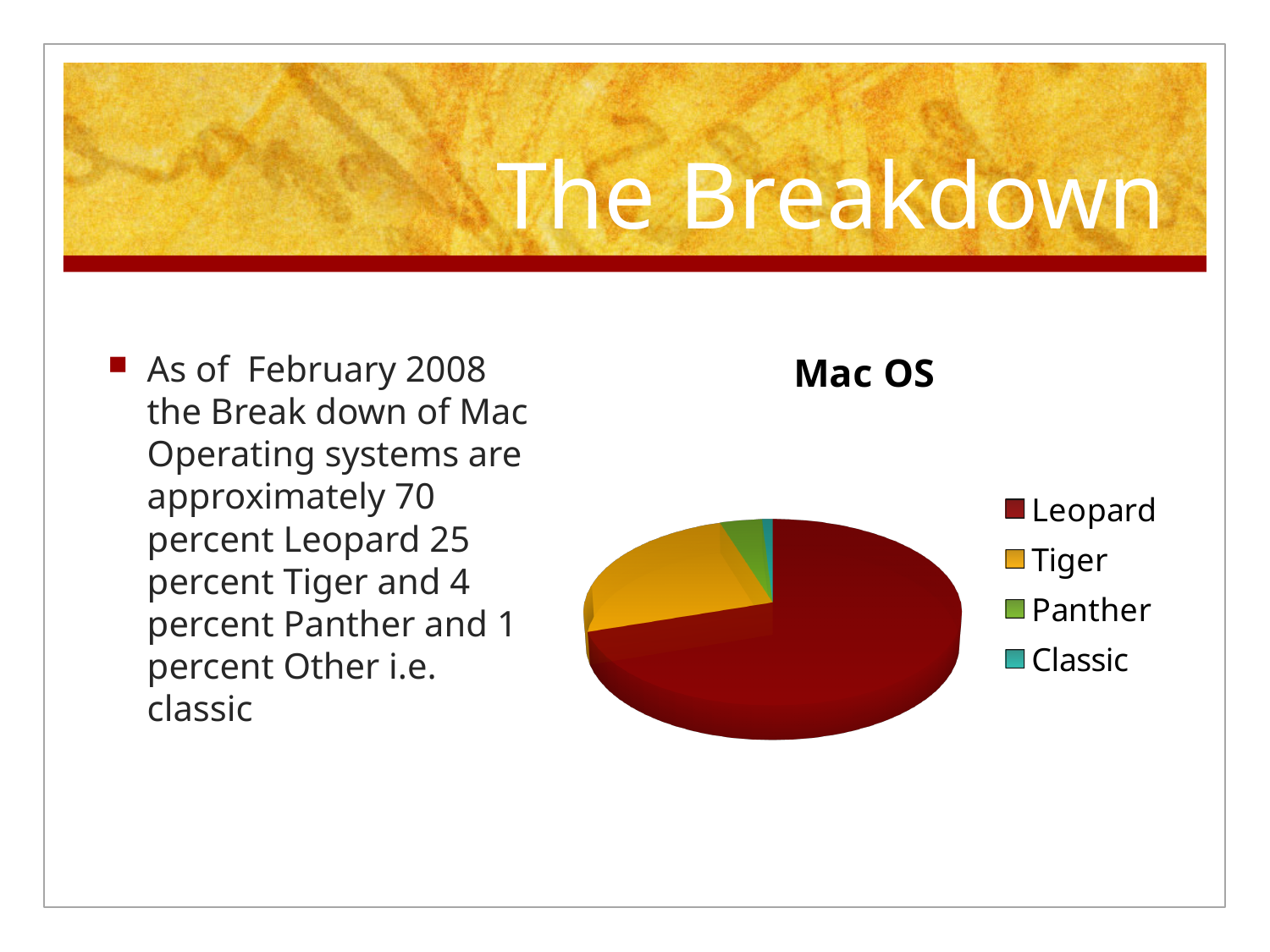
What kind of chart is shown on the slide? Pie chart Which slice is larger, Tiger or Panther? Tiger Which slice is larger, Panther or Classic? Panther What is the title of the chart? Mac OS Which category is shown in green in the legend? Panther Which category has the smallest slice of the pie? Classic How many categories does the pie chart show? 4 Which category is the second-largest slice of the pie? Tiger Which category has the largest slice of the pie? Leopard Which slice is larger, Leopard or Tiger? Leopard